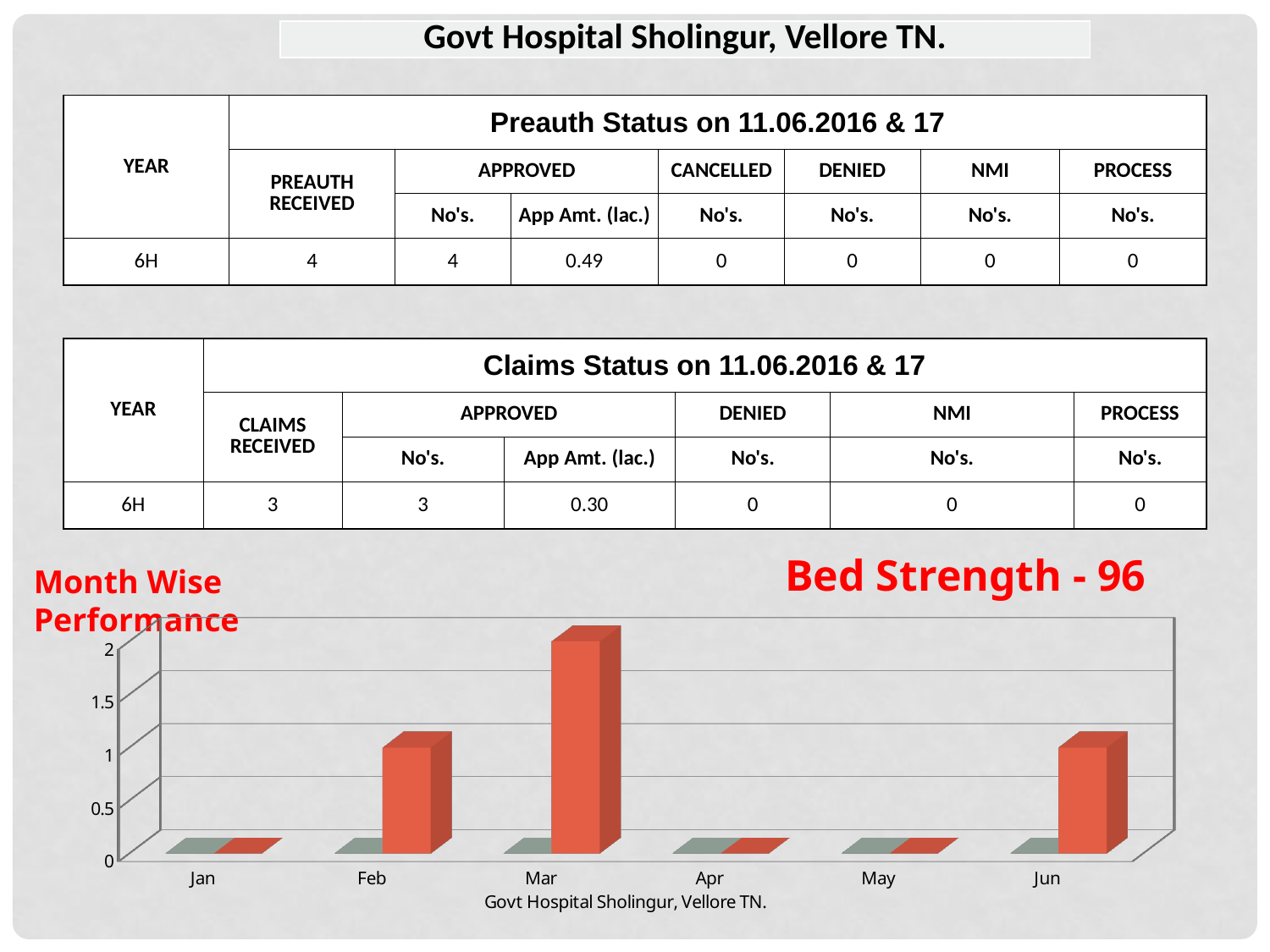
What is the value of the orange bar for Mar? 2 What kind of chart is shown on the slide? bar chart What is the value of the orange bar for Feb? 1 What is the value of the orange bar for Jan? 0 Which month has the highest orange bar in the chart? Mar Is the value of the orange bar for Feb greater or less than 1.5? less Is the value of the orange bar for Mar greater or less than 1.5? greater What is the value of the orange bar for Jun? 1 Which month has a larger orange bar, Mar or Feb? Mar What is the difference between the orange bar values for Mar and Feb? 1 How many months are shown on the x axis of the chart? 6 What text appears below the x axis of the chart? Govt Hospital Sholingur, Vellore TN.